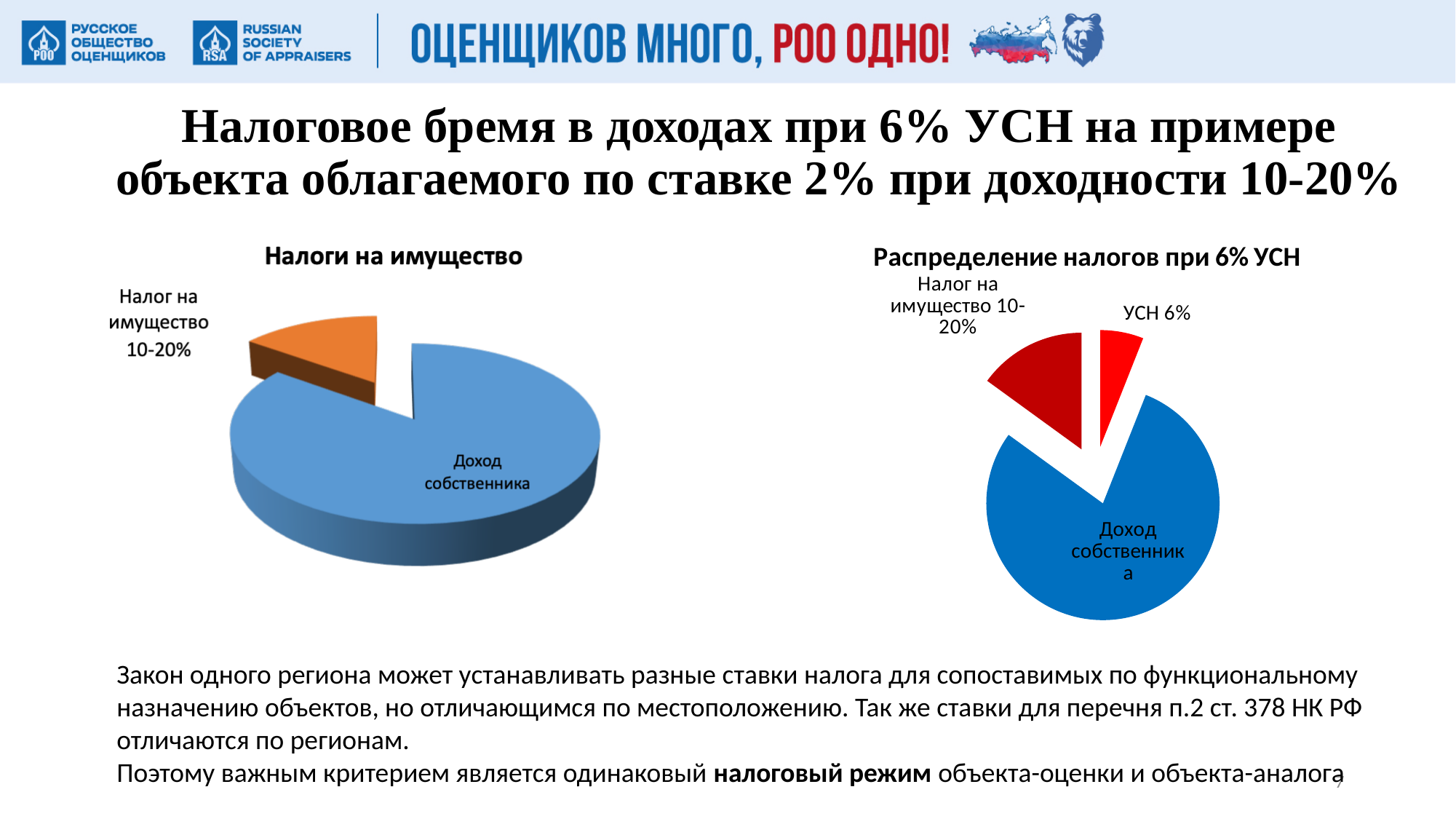
In the right chart "Распределение налогов при 6% УСН", which slice is the largest? Доход собственника In the left chart "Налоги на имущество", what colour is the "Налог на имущество 10-20%" slice? orange In the right chart "Распределение налогов при 6% УСН", which slice is the smallest? УСН 6% What kind of chart is the right chart titled "Распределение налогов при 6% УСН"? pie chart In the left chart "Налоги на имущество", which slice is larger: "Доход собственника" or "Налог на имущество 10-20%"? Доход собственника How many slices does the right chart "Распределение налогов при 6% УСН" have? 3 In the right chart "Распределение налогов при 6% УСН", which slice is larger: "Налог на имущество 10-20%" or "УСН 6%"? Налог на имущество 10-20% In the left chart "Налоги на имущество", which slice is the largest? Доход собственника How many slices does the left chart "Налоги на имущество" have? 2 What kind of chart is the left chart titled "Налоги на имущество"? pie chart What is the title of the chart on the right side of the slide? Распределение налогов при 6% УСН In the left chart "Налоги на имущество", which slice is the smallest? Налог на имущество 10-20%